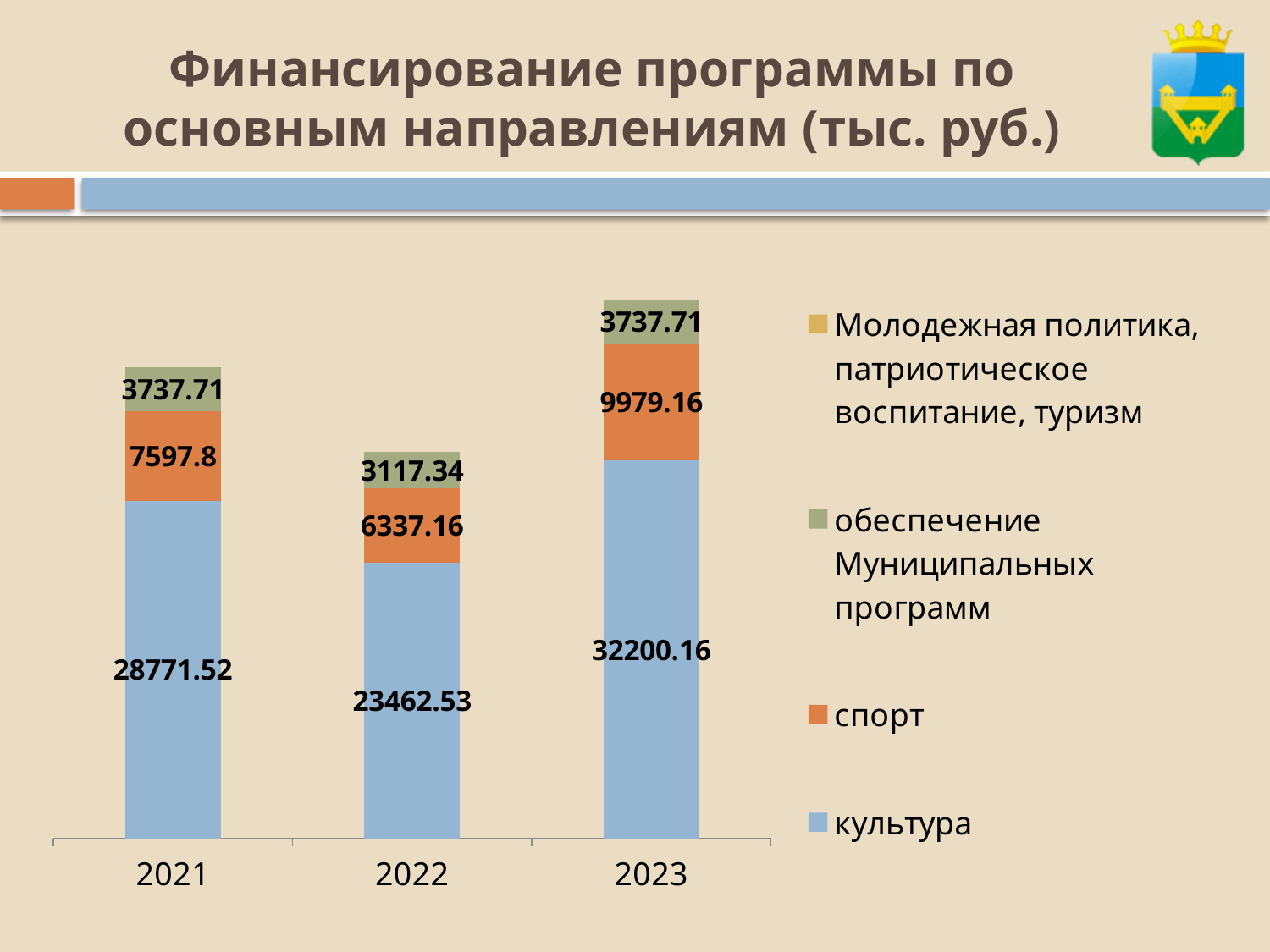
Which is larger: the спорт value in 2021 or in 2022? 2021 In which year is the value for культура the highest? 2023 What is the value for обеспечение Муниципальных программ in 2022? 3117.34 How many years are shown on the x axis? 3 What is the value for культура in 2023? 32200.16 What is the value for спорт in 2021? 7597.8 What kind of chart is shown on the slide? Stacked bar chart In which year is the value for спорт the lowest? 2022 What is the difference between the спорт values for 2023 and 2022? 3642 How many series does the legend list? 4 Which series is shown in orange in the legend? спорт What is the difference between the культура values for 2023 and 2021? 3428.64